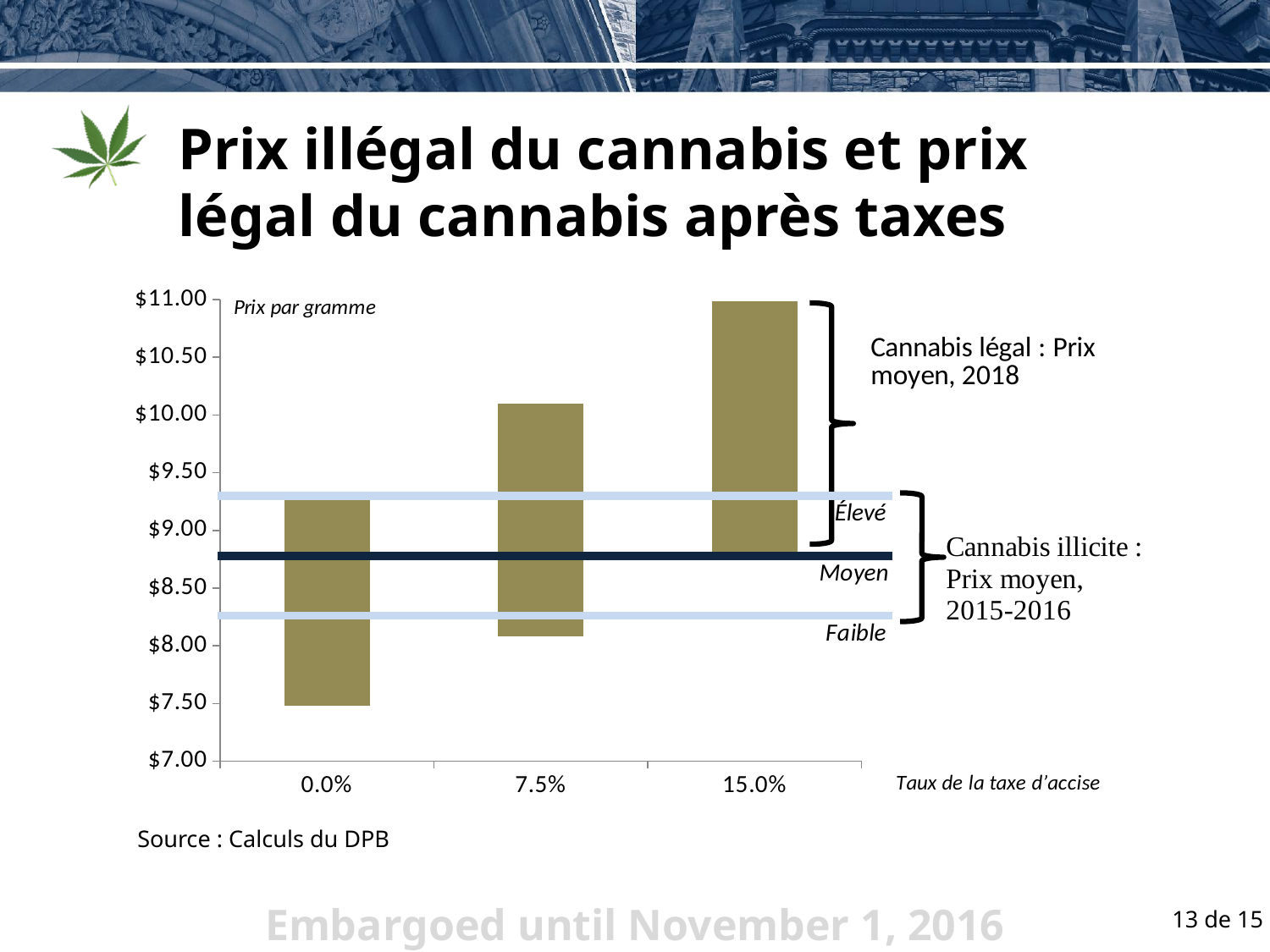
Is the bottom of the bar for the 0.0% excise tax rate greater or less than $8.00? less Which excise tax rate has the bar reaching the highest price per gramme? 15.0% Is the bottom of the bar for the 15.0% excise tax rate greater or less than $8.50? greater Which excise tax rate has the bar reaching the lowest price per gramme? 0.0% How many excise tax rates are shown on the x axis of the chart? 3 What kind of chart is shown on the slide? bar chart Is the top of the bar for the 7.5% excise tax rate greater or less than $9.50? greater Do the legal cannabis price bars rise or fall as the excise tax rate increases along the x axis? rise What is the label of the x axis of the chart? Taux de la taxe d'accise What are the three labels given to the horizontal lines for the illicit cannabis price? Élevé, Moyen, Faible